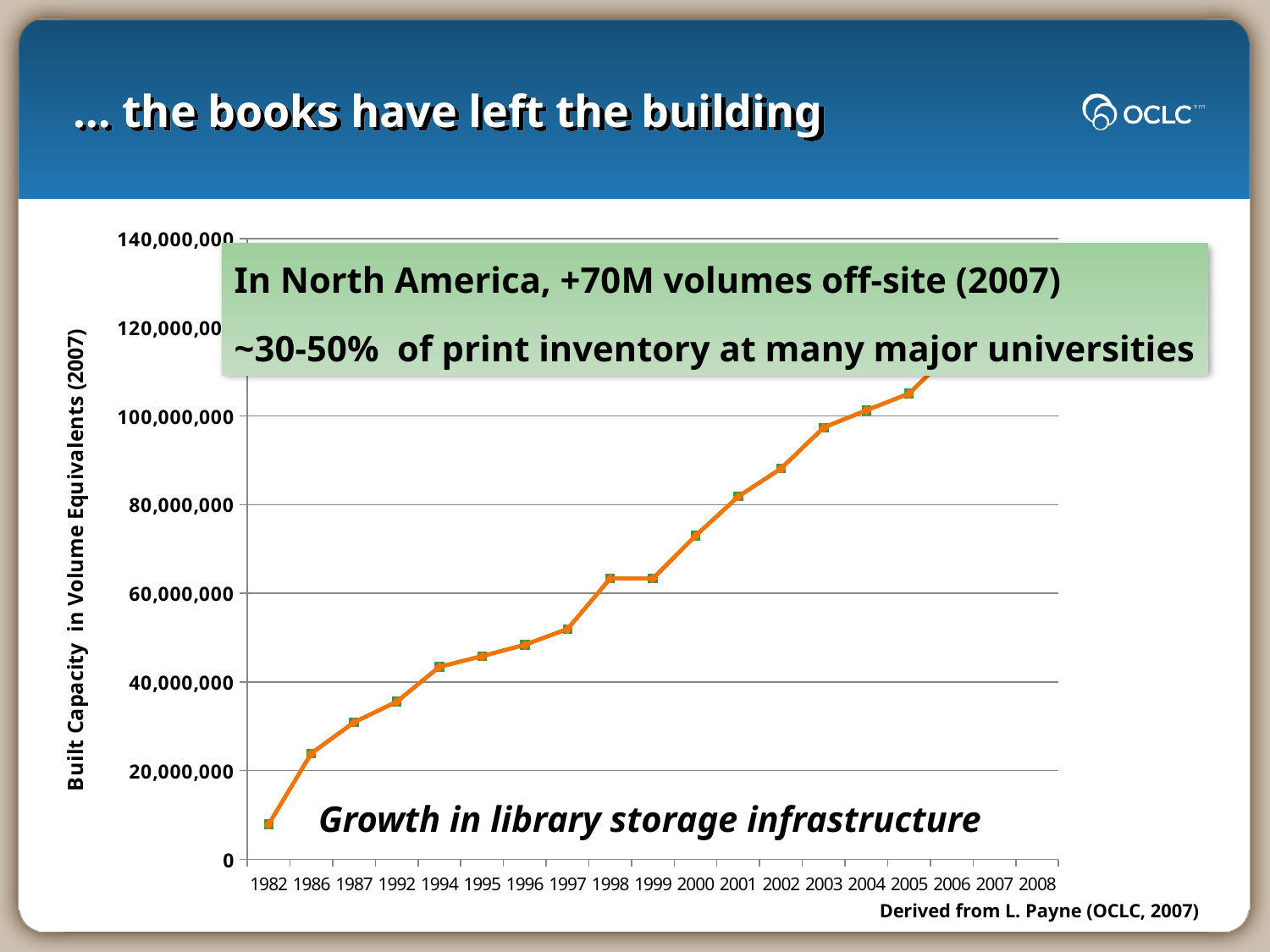
Which year has the larger value, 1997 or 2001? 2001 What is the label on the vertical axis of the chart? Built Capacity in Volume Equivalents (2007) Is the value for 2003 greater or less than 80,000,000? greater Which year has the lowest built capacity in the chart? 1982 What is the title printed inside the chart area? Growth in library storage infrastructure Is the value for 2000 greater or less than 60,000,000? greater What kind of chart is shown on the slide? line chart Is the value for 1992 greater or less than 40,000,000? less How many year labels are shown on the x axis of the chart? 19 Do the values in the chart generally rise or fall from 1982 to 2005? rise